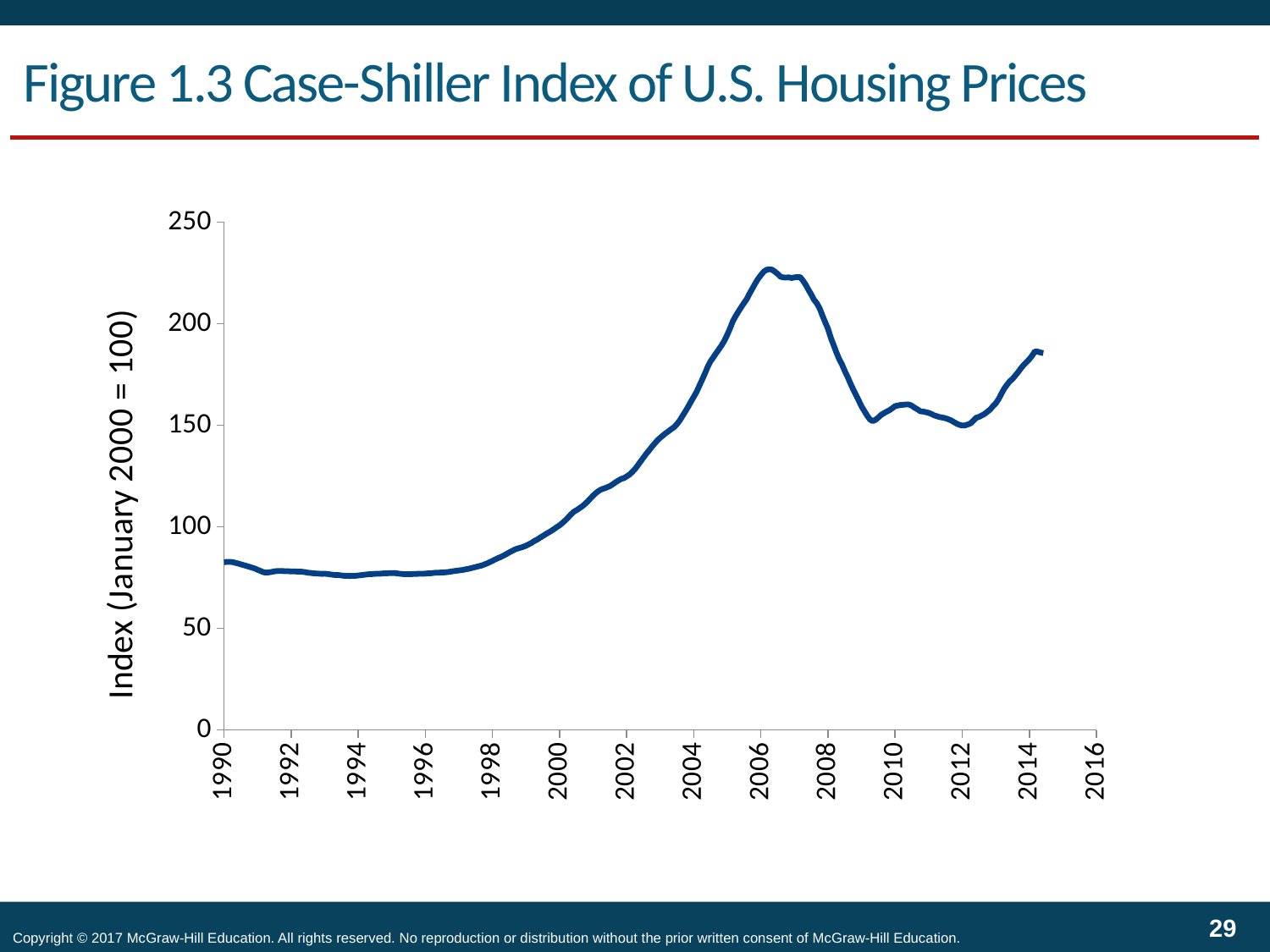
Does the index rise or fall between 1998 and 2006? rise Is the value of the index in 2006 greater or less than 200? greater Is the value of the index in 1990 greater or less than 100? less Which is larger, the index value in 2006 or in 2012? 2006 Does the index rise or fall between 2006 and 2009? fall What is the title of the chart on the slide? Figure 1.3 Case-Shiller Index of U.S. Housing Prices What kind of chart is shown on the slide? line chart Around which year does the index reach its highest value? 2006 Is the value of the index in 2002 greater or less than 150? less How many lines (series) are plotted on the chart? 1 What is the label on the vertical axis of the chart? Index (January 2000 = 100)